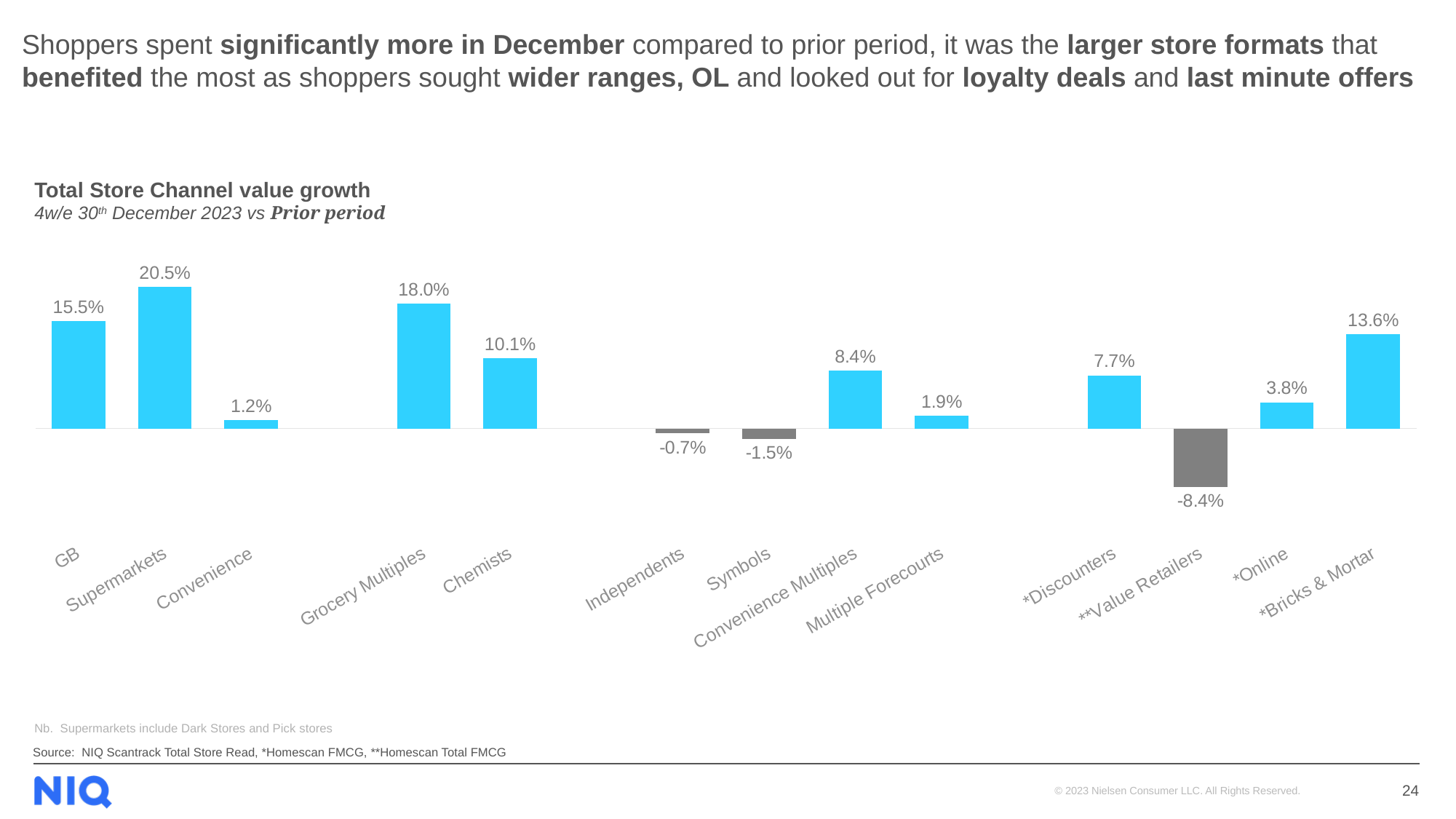
What is the value growth for Grocery Multiples? 18.0% What is the title of the chart? Total Store Channel value growth Which channel has the highest value growth? Supermarkets Which has the larger value growth, Chemists or Convenience Multiples? Chemists What is the value growth for Supermarkets? 20.5% What is the value growth for Value Retailers? -8.4% Which channel has the lowest value growth? Value Retailers What kind of chart is shown on the slide? Bar chart What is the value growth for Online? 3.8% What is the difference between the value growth for Supermarkets and for GB? 5.0% What is the difference between the value growth for Bricks & Mortar and for Online? 9.8% How many channels are shown on the chart? 13